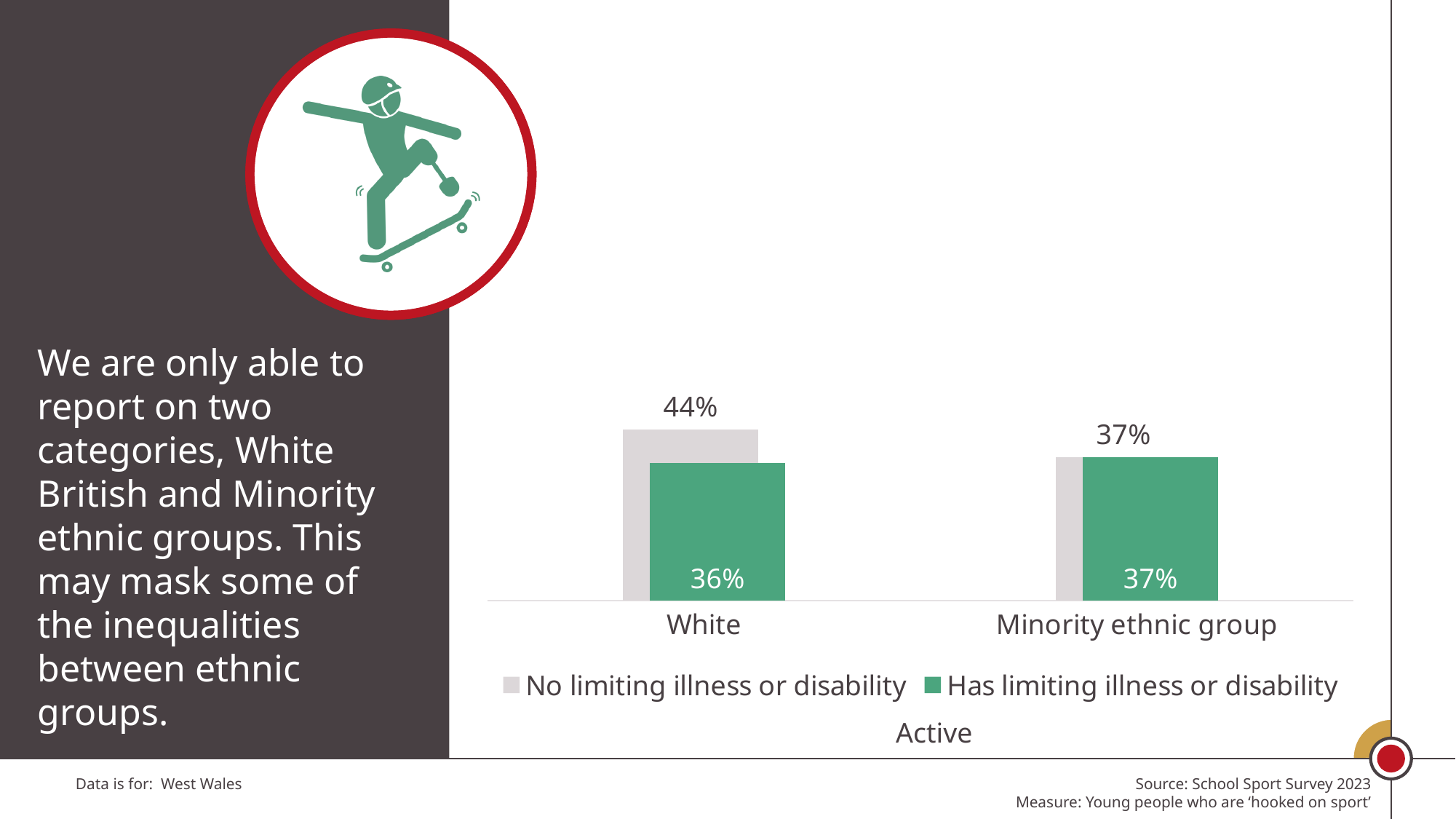
What is the value for Minority ethnic group in the 'Has limiting illness or disability' series? 37% What kind of chart is shown on the slide? Bar chart What is the value for White in the 'Has limiting illness or disability' series? 36% What is the difference between the 'No limiting illness or disability' values for White and Minority ethnic group? 7% Which category has the lowest value in the 'Has limiting illness or disability' series? White Which category has the highest value in the 'No limiting illness or disability' series? White What is the value for White in the 'No limiting illness or disability' series? 44% How many series does the legend list? 2 For White, which is larger: the 'No limiting illness or disability' value or the 'Has limiting illness or disability' value? No limiting illness or disability What is the difference between the 'No limiting illness or disability' and 'Has limiting illness or disability' values for White? 8% How many categories are shown on the x axis? 2 What is the value for Minority ethnic group in the 'No limiting illness or disability' series? 37%